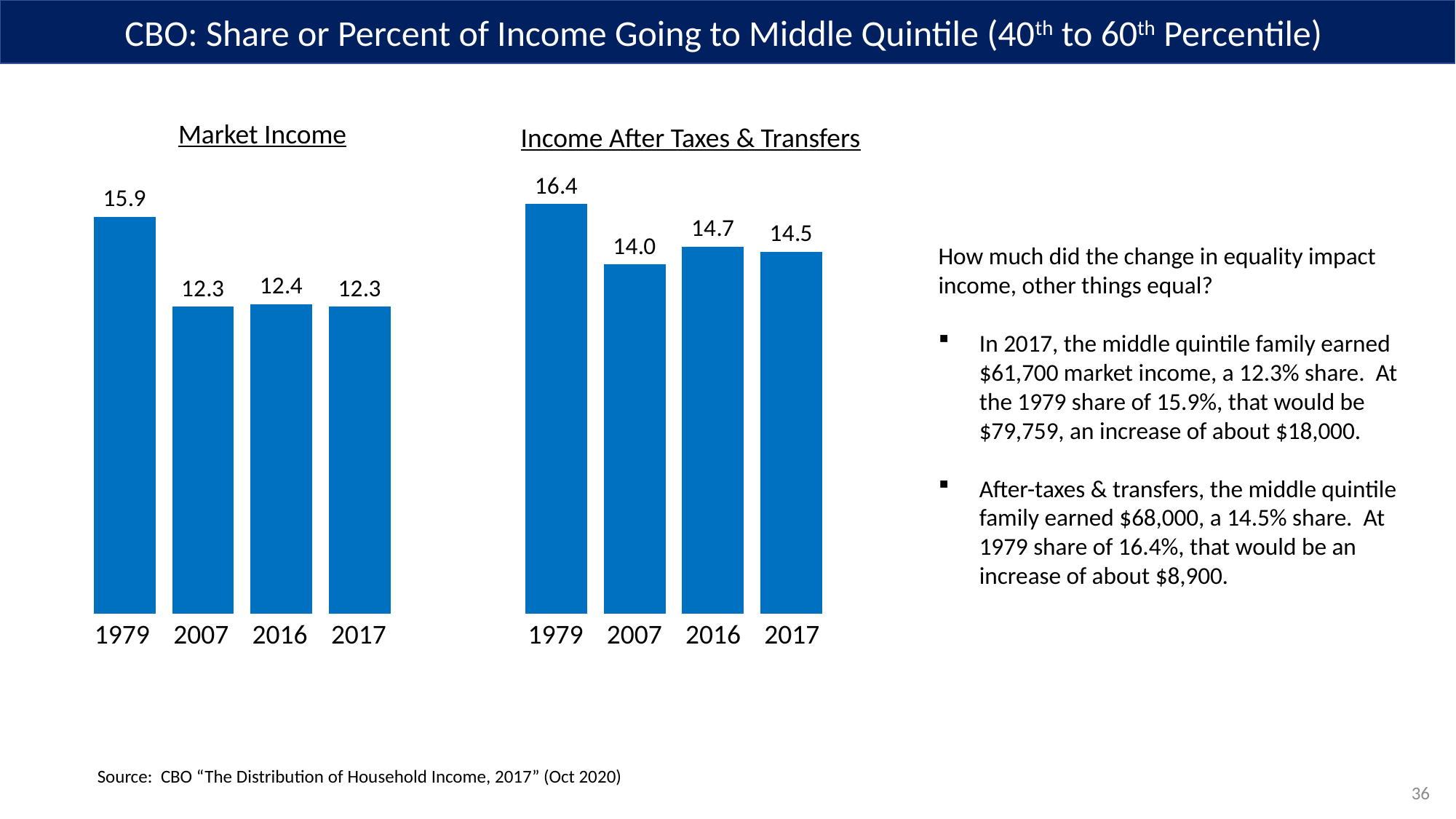
In the Income After Taxes & Transfers chart, what is the value for 2007? 14.0 In the Income After Taxes & Transfers chart, what is the difference between the 1979 value and the 2017 value? 1.9 In the Market Income chart, which year has the highest value? 1979 What type of chart is the Income After Taxes & Transfers chart? Bar chart In the Market Income chart, does the value rise or fall from 1979 to 2007? Fall In the Income After Taxes & Transfers chart, which is larger, the value for 2016 or the value for 2017? 2016 In the Market Income chart, what is the difference between the 1979 value and the 2017 value? 3.6 In the Income After Taxes & Transfers chart, what is the value for 2016? 14.7 In the Income After Taxes & Transfers chart, which year has the lowest value? 2007 How many bars are in the Market Income chart? 4 What is the title of the chart on the left? Market Income In the Market Income chart, what is the value for 1979? 15.9